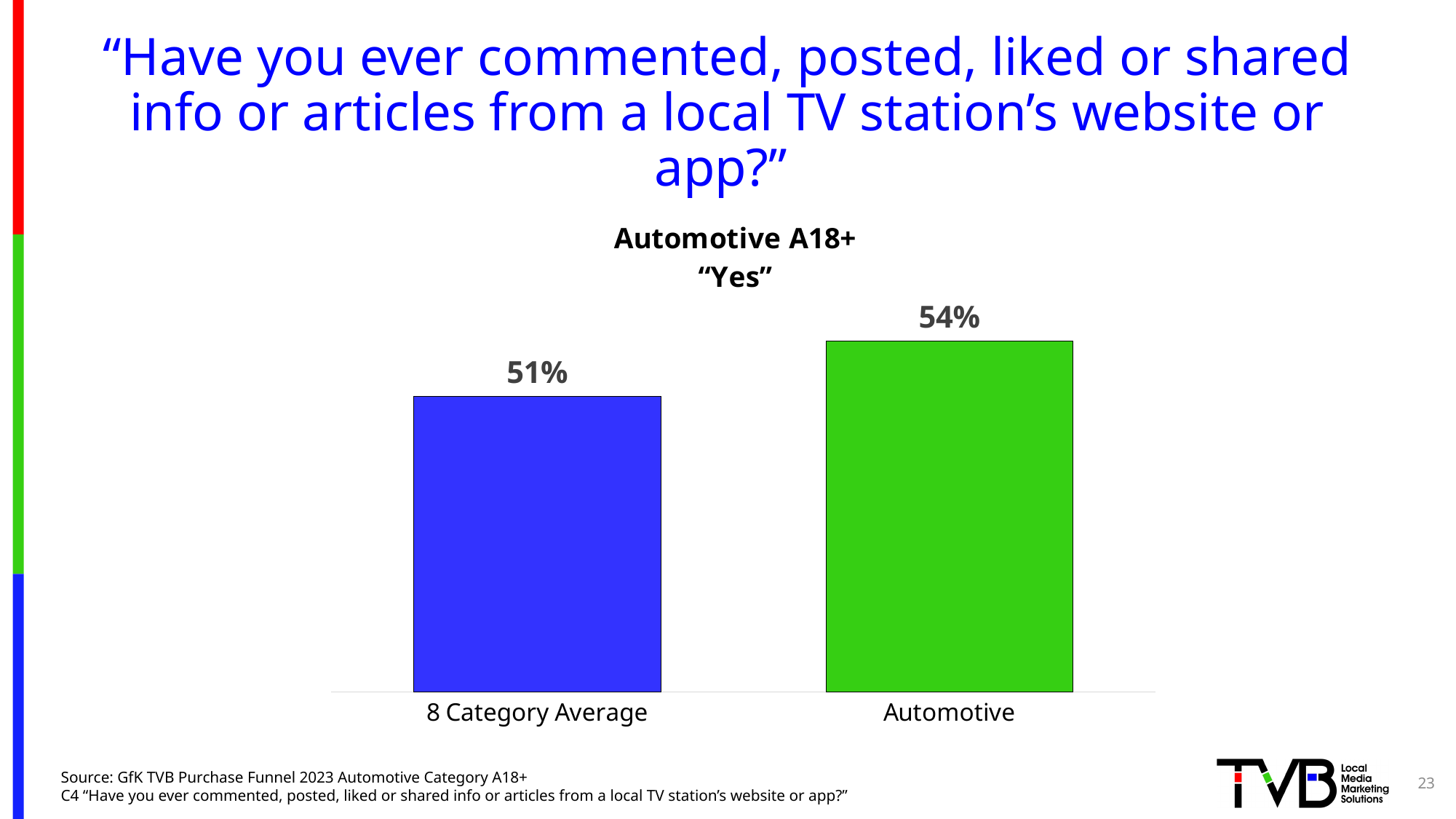
What is the difference between the Automotive value and the 8 Category Average value? 3% What is the title of the chart? Automotive A18+ "Yes" What is the value for 8 Category Average? 51% Which category has the lowest value? 8 Category Average Which category has the highest value? Automotive What is the value for Automotive? 54% What kind of chart is shown on the slide? Bar chart What colour is the bar for Automotive? Green Which is larger, the value for Automotive or the value for 8 Category Average? Automotive How many categories are shown in the chart? 2